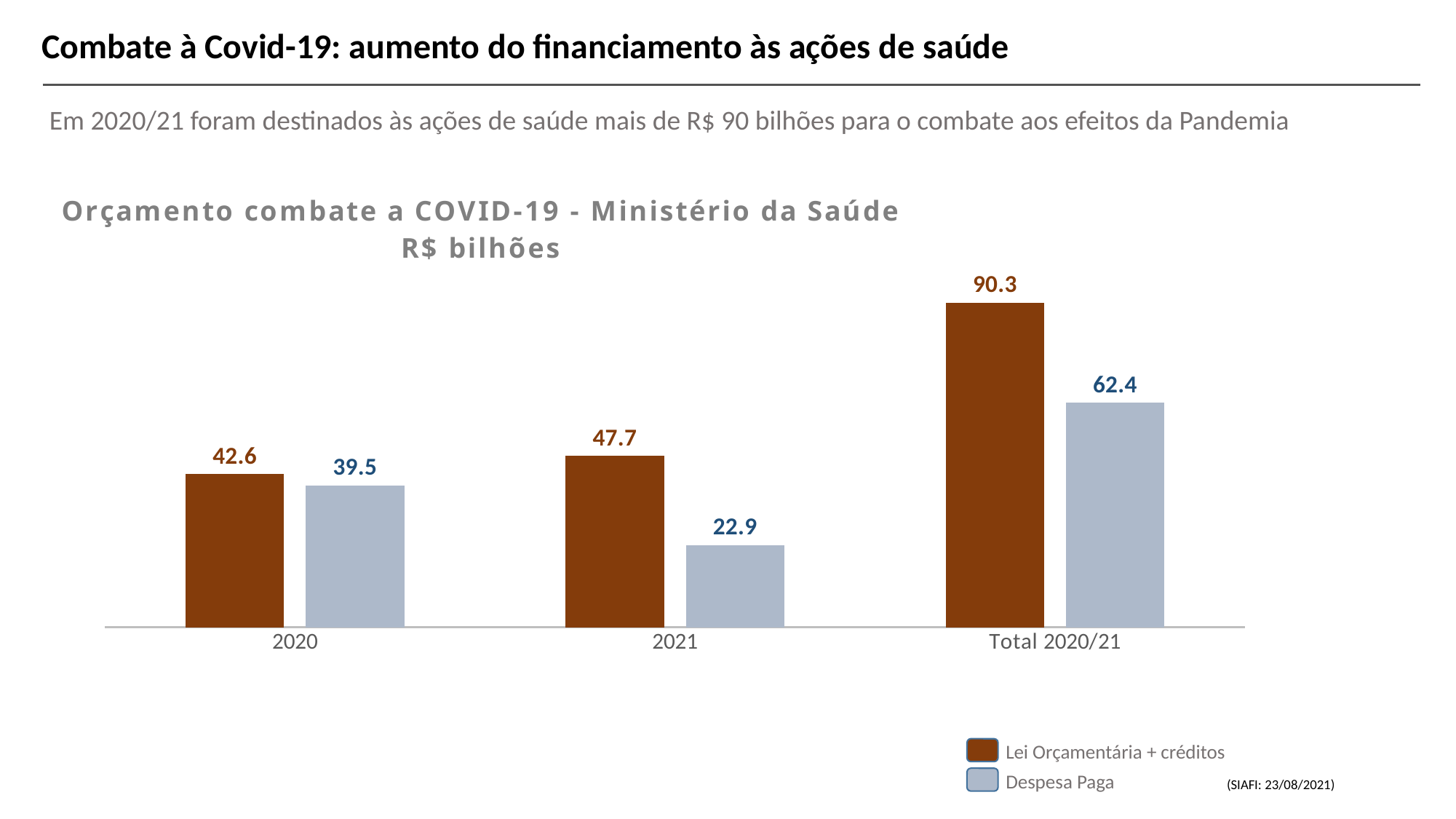
How many categories are shown on the x axis? 3 What is the value of Despesa Paga for 2021? 22.9 What is the value of Despesa Paga for Total 2020/21? 62.4 Which category has the highest Lei Orçamentária + créditos value? Total 2020/21 What is the value of Lei Orçamentária + créditos for 2021? 47.7 What unit is stated in the chart title? R$ bilhões What is the value of Lei Orçamentária + créditos for 2020? 42.6 What is the difference between Lei Orçamentária + créditos and Despesa Paga for 2021? 24.8 What kind of chart is shown on the slide? Bar chart Which category has the lowest Despesa Paga value? 2021 Which is larger for 2020: Lei Orçamentária + créditos or Despesa Paga? Lei Orçamentária + créditos How many series does the legend list? 2